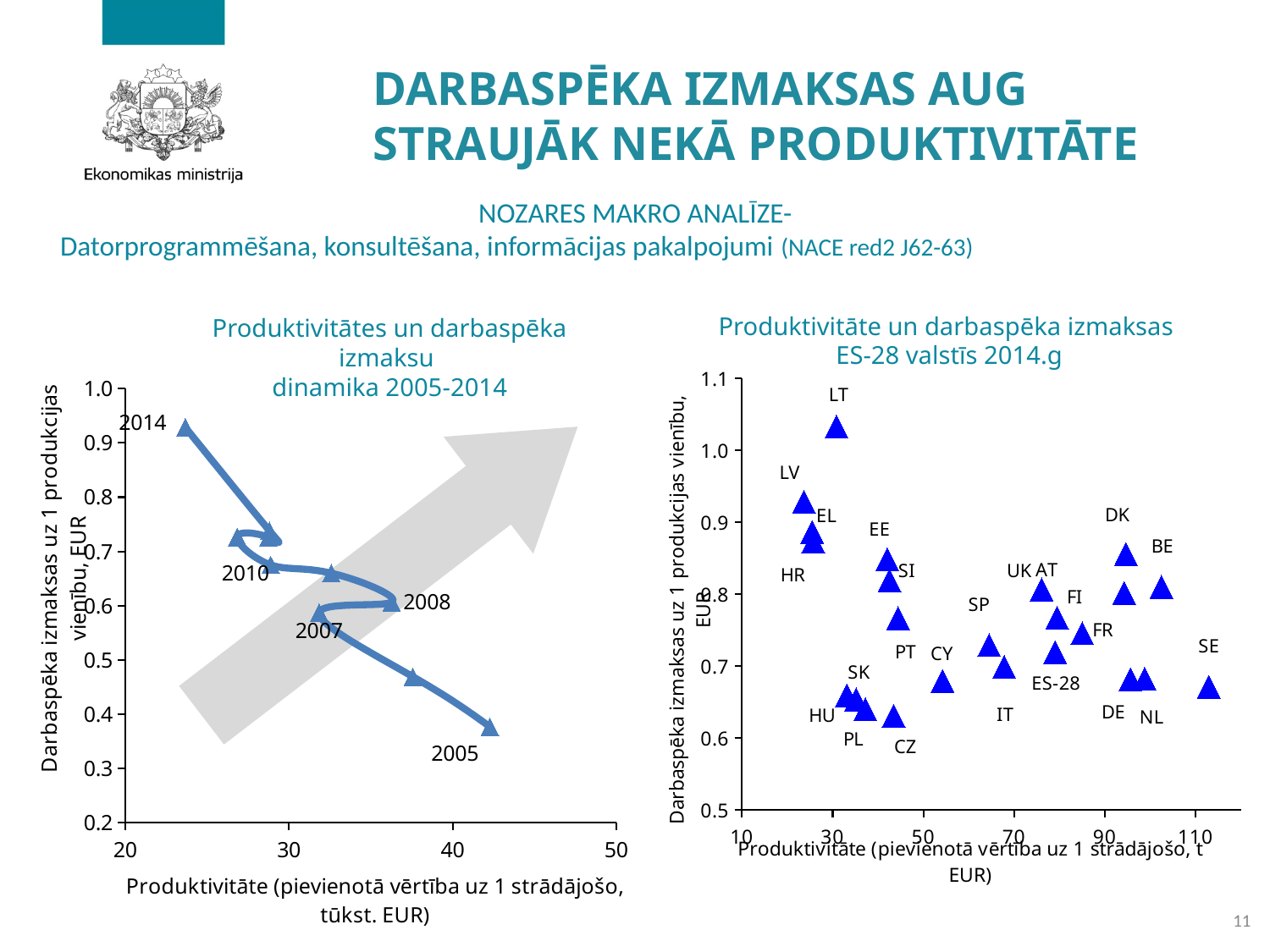
In the left chart, which year has the higher productivity, 2008 or 2010? 2008 In the right chart 'Produktivitāte un darbaspēka izmaksas ES-28 valstīs 2014.g', which country has the highest labour cost per unit of output? LT In the left chart, how does labour cost per unit of output change from 2005 to 2014? it rises In the right chart, which has the higher labour cost per unit of output, LT or LV? LT In the right chart, is the labour cost value for LT greater or less than 1.0? greater In the left chart, is the labour cost value for 2014 greater or less than 0.9? greater In the left chart, is the productivity value for 2005 greater or less than 40? greater What kind of chart is the left chart titled 'Produktivitātes un darbaspēka izmaksu dinamika 2005-2014'? scatter chart In the right chart 'Produktivitāte un darbaspēka izmaksas ES-28 valstīs 2014.g', which country has the highest productivity? SE In the left chart 'Produktivitātes un darbaspēka izmaksu dinamika 2005-2014', which year has the highest labour cost per unit of output? 2014